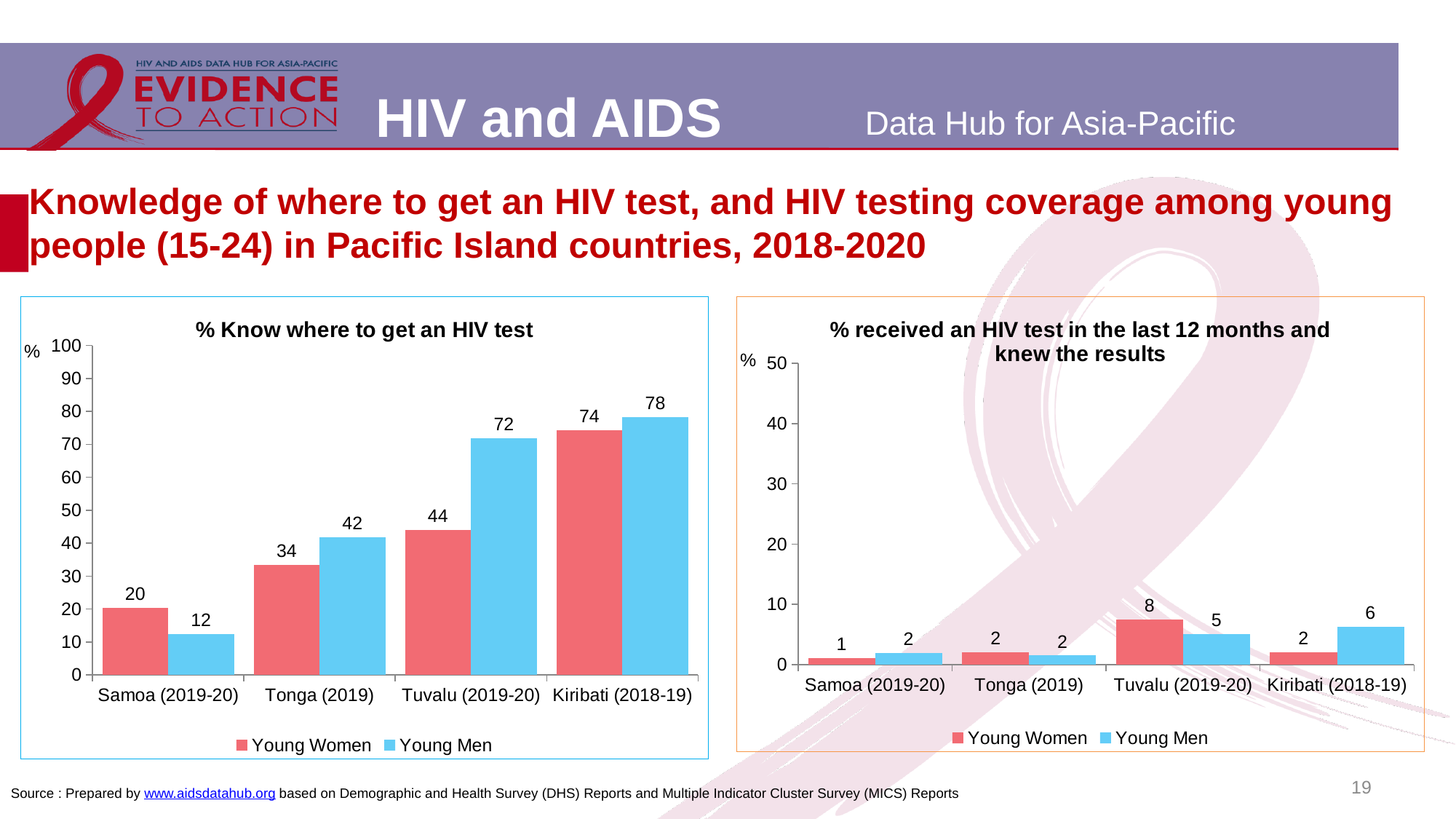
In the '% received an HIV test in the last 12 months and knew the results' chart, which is larger in Kiribati (2018-19): Young Women or Young Men? Young Men In the '% received an HIV test in the last 12 months and knew the results' chart, which country has the highest value for Young Men? Kiribati (2018-19) In the '% Know where to get an HIV test' chart, which country has the lowest value for Young Women? Samoa (2019-20) How many series does the legend of the '% received an HIV test in the last 12 months and knew the results' chart list? 2 How many countries are shown on the x axis of the '% Know where to get an HIV test' chart? 4 In the '% Know where to get an HIV test' chart, what is the value for Young Women in Tonga (2019)? 34 In the '% received an HIV test in the last 12 months and knew the results' chart, what is the difference between Young Women and Young Men in Tuvalu (2019-20)? 3 In the '% Know where to get an HIV test' chart, is the value for Young Women in Kiribati (2018-19) greater or less than 70? greater In the '% Know where to get an HIV test' chart, what is the value for Young Men in Tuvalu (2019-20)? 72 In the '% Know where to get an HIV test' chart, which country has the highest value for Young Men? Kiribati (2018-19) In the '% Know where to get an HIV test' chart, what is the difference between Young Men and Young Women in Samoa (2019-20)? 8 In the '% received an HIV test in the last 12 months and knew the results' chart, what is the value for Young Women in Tuvalu (2019-20)? 8